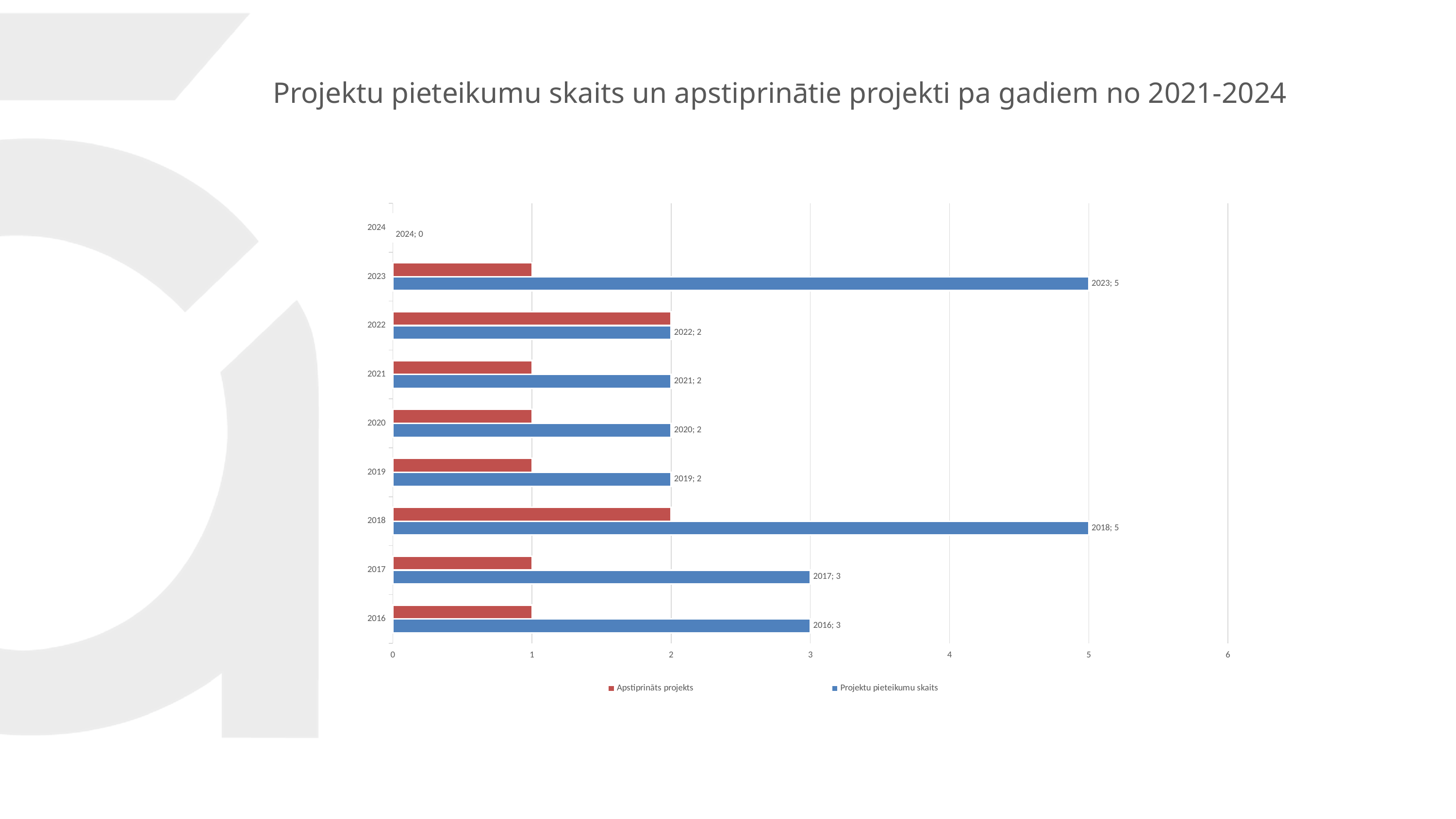
How many years (categories) are shown on the vertical axis? 9 What is the value of Projektu pieteikumu skaits for 2023? 5 Which year has the lowest value for Projektu pieteikumu skaits? 2024 What is the value of Apstiprināts projekts for 2018? 2 How many series does the legend list? 2 What is the value of Projektu pieteikumu skaits for 2017? 3 What type of chart is shown on the slide? bar chart What is the difference between Projektu pieteikumu skaits for 2018 and for 2019? 3 Which series is shown in red in the legend? Apstiprināts projekts Which is larger: Projektu pieteikumu skaits for 2017 or for 2022? 2017 Is the value of Projektu pieteikumu skaits for 2018 greater or less than 4? greater What is the value of Projektu pieteikumu skaits for 2024? 0